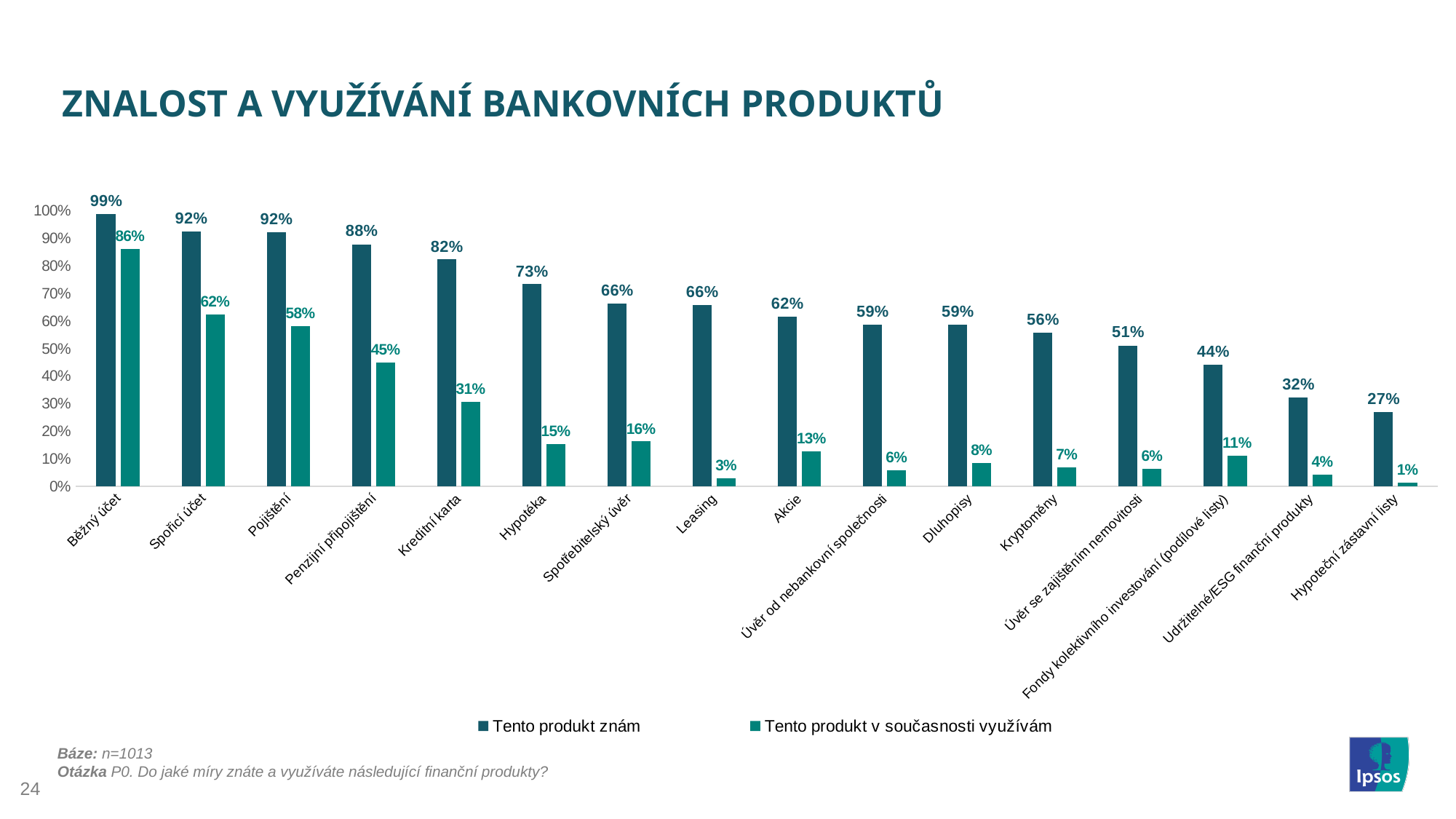
What is the title of the chart on the slide? ZNALOST A VYUŽÍVÁNÍ BANKOVNÍCH PRODUKTŮ Do the 'Tento produkt znám' values rise or fall from left to right along the x axis? Fall What is the value for Běžný účet in the 'Tento produkt znám' series? 99% Which category has the lowest value in the 'Tento produkt v současnosti využívám' series? Hypoteční zástavní listy What is the value for Kryptoměny in the 'Tento produkt znám' series? 56% Which is larger: the 'Tento produkt v současnosti využívám' value for Akcie or for Dluhopisy? Akcie How many categories are shown on the x axis? 16 What kind of chart is shown on the slide? Bar chart What is the value for Penzijní připojištění in the 'Tento produkt v současnosti využívám' series? 45% Which category has the highest value in the 'Tento produkt znám' series? Běžný účet How many series does the legend list? 2 What is the difference between the 'Tento produkt znám' and 'Tento produkt v současnosti využívám' values for Hypotéka? 58%